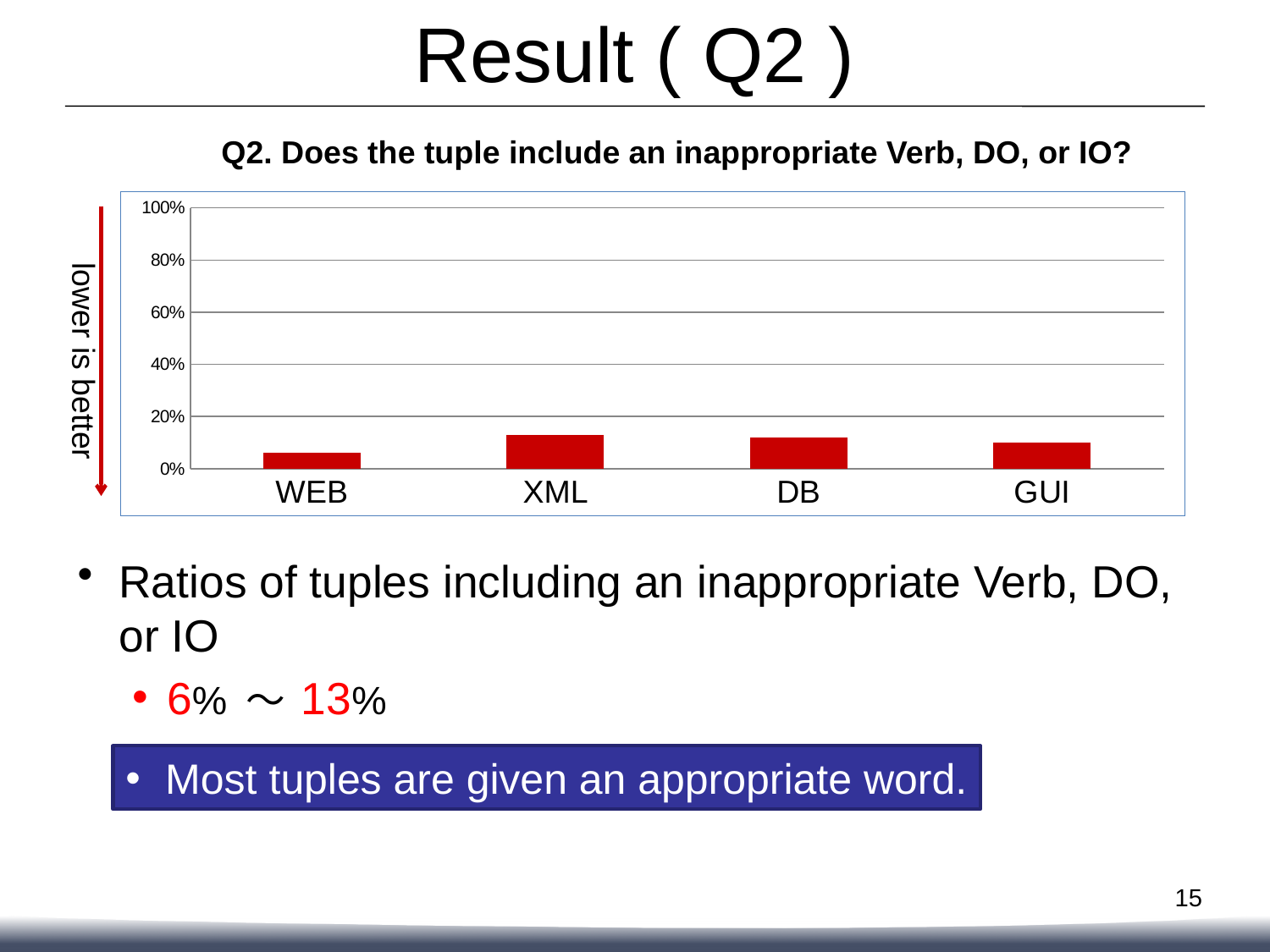
Which category has the lowest bar in the chart? WEB Which is larger, the value for WEB or the value for XML? XML What is the highest tick label on the y axis of the chart? 100% What question is the chart titled with? Q2. Does the tuple include an inappropriate Verb, DO, or IO? What kind of chart is shown on the slide? bar chart Is the value for XML greater or less than 20%? less Which is larger, the value for WEB or the value for GUI? GUI How many categories are shown on the x axis of the chart? 4 Is the value for GUI greater or less than 20%? less Is the value for WEB greater or less than 20%? less